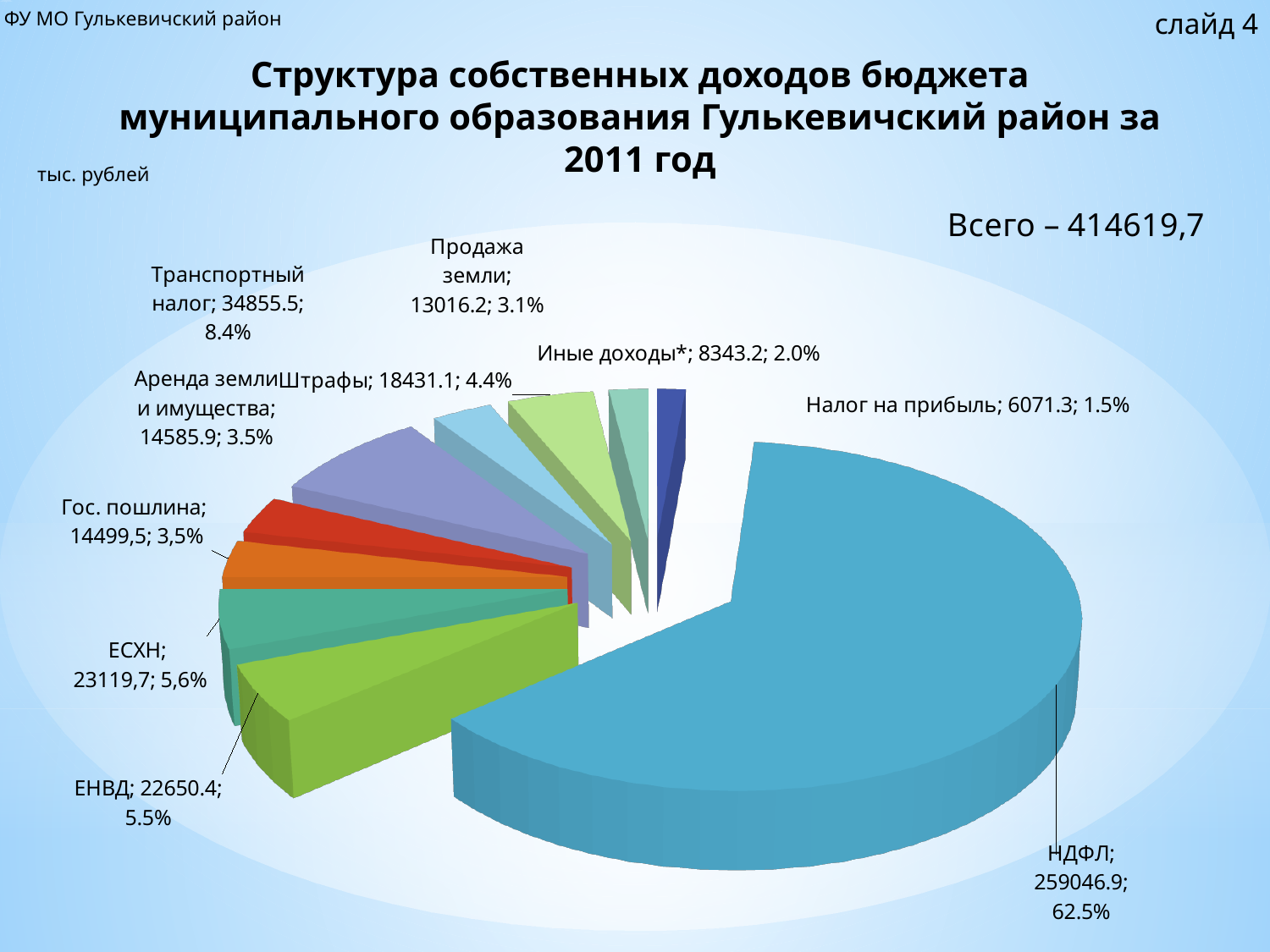
Which category has the smallest slice? Налог на прибыль Which category has the largest slice? НДФЛ What is the difference between the values for Транспортный налог and Штрафы? 16424.4 What total (Всего) is stated on the slide? 414619,7 What share of the pie does ЕНВД represent? 5.5% What is the value for Штрафы? 18431.1 How many slices does the pie chart have? 10 What share of the pie does Продажа земли represent? 3.1% Which is larger, ЕСХН or ЕНВД? ЕСХН What kind of chart is shown on the slide? pie chart What is the value for НДФЛ? 259046.9 What is the value for Транспортный налог? 34855.5